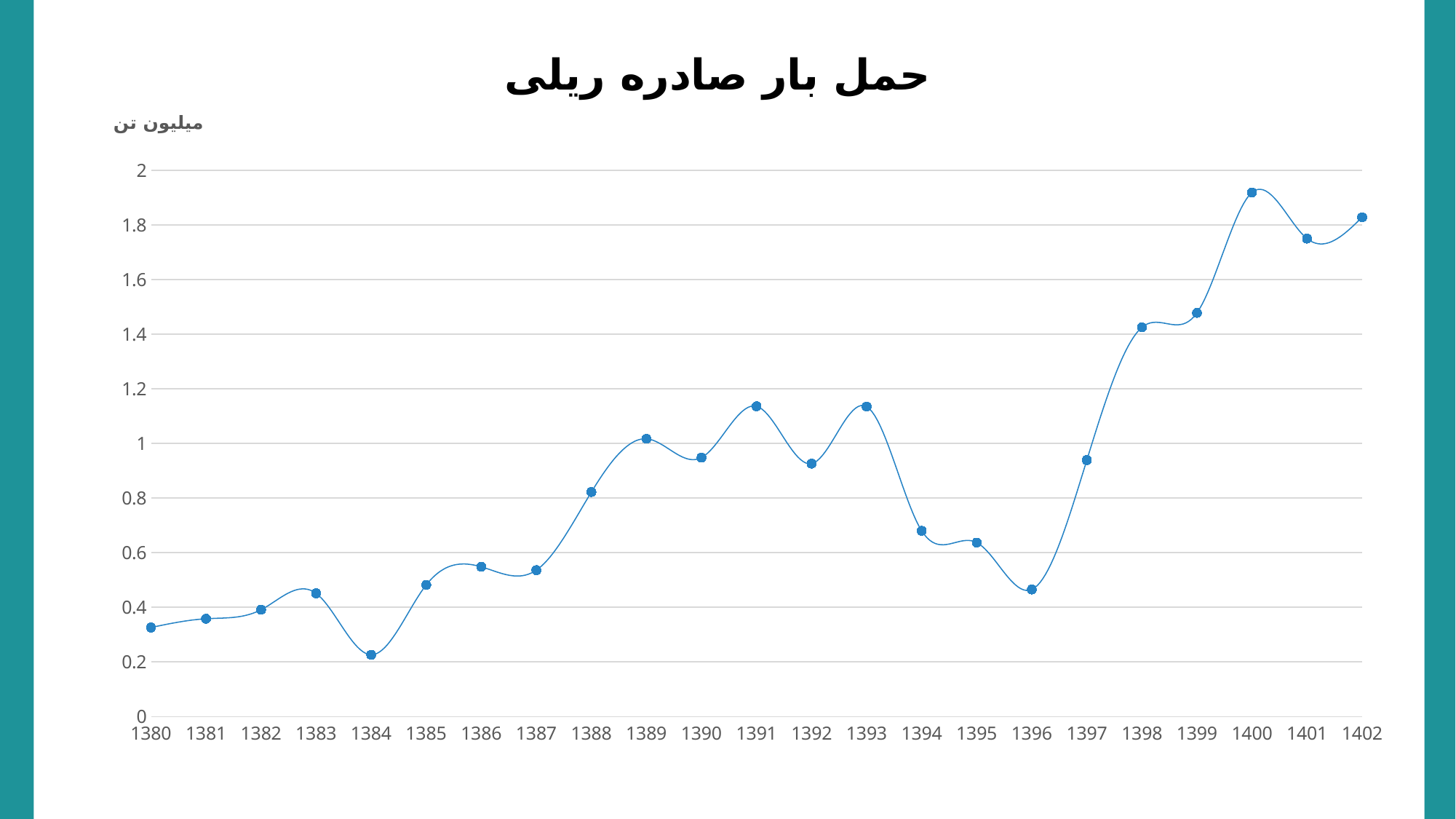
Overall, do the values rise or fall from 1380 to 1402? rise Is the value for 1391 greater or less than 1? greater Is the value for 1384 greater or less than 0.4? less Is the value for 1400 greater or less than 1.8? greater What kind of chart is shown on the slide? line chart Which year has the lowest value? 1384 What unit is shown above the y axis? میلیون تن Which is larger, the value for 1383 or the value for 1384? 1383 How many years (data points) are plotted on the x axis? 23 Which is larger, the value for 1400 or the value for 1402? 1400 Which year has the highest value? 1400